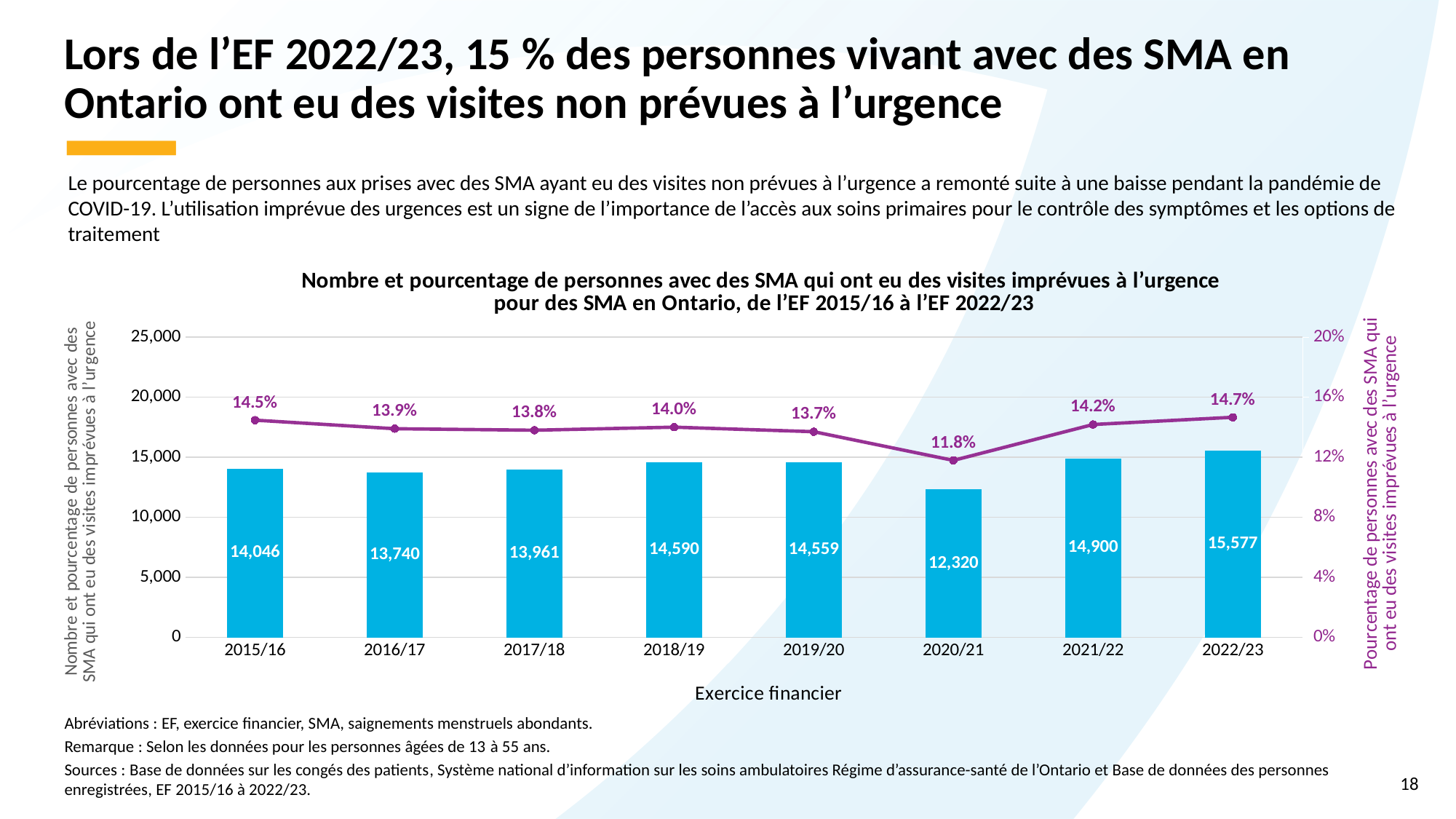
Which fiscal year has the larger number of people with unplanned emergency visits, 2018/19 or 2019/20? 2018/19 What is the number of people with SMA who had unplanned emergency visits in 2016/17? 13,740 How many fiscal years are shown on the x axis of the chart? 8 What percentage of people with SMA had unplanned emergency visits in 2020/21? 11.8% What is the number of people with SMA who had unplanned emergency visits in 2022/23? 15,577 Is the number of people with unplanned emergency visits in 2021/22 greater or less than 15,000? less Which fiscal year has the highest number of people with SMA who had unplanned emergency visits? 2022/23 What is the label of the x axis of the chart? Exercice financier What is the difference in the number of people with unplanned emergency visits between 2022/23 and 2020/21? 3,257 Which fiscal year has the lowest percentage of people with SMA who had unplanned emergency visits? 2020/21 Does the percentage of people with SMA who had unplanned emergency visits rise or fall from 2020/21 to 2022/23? Rise What kind of chart is used to show the number of people with SMA who had unplanned emergency visits? Bar chart